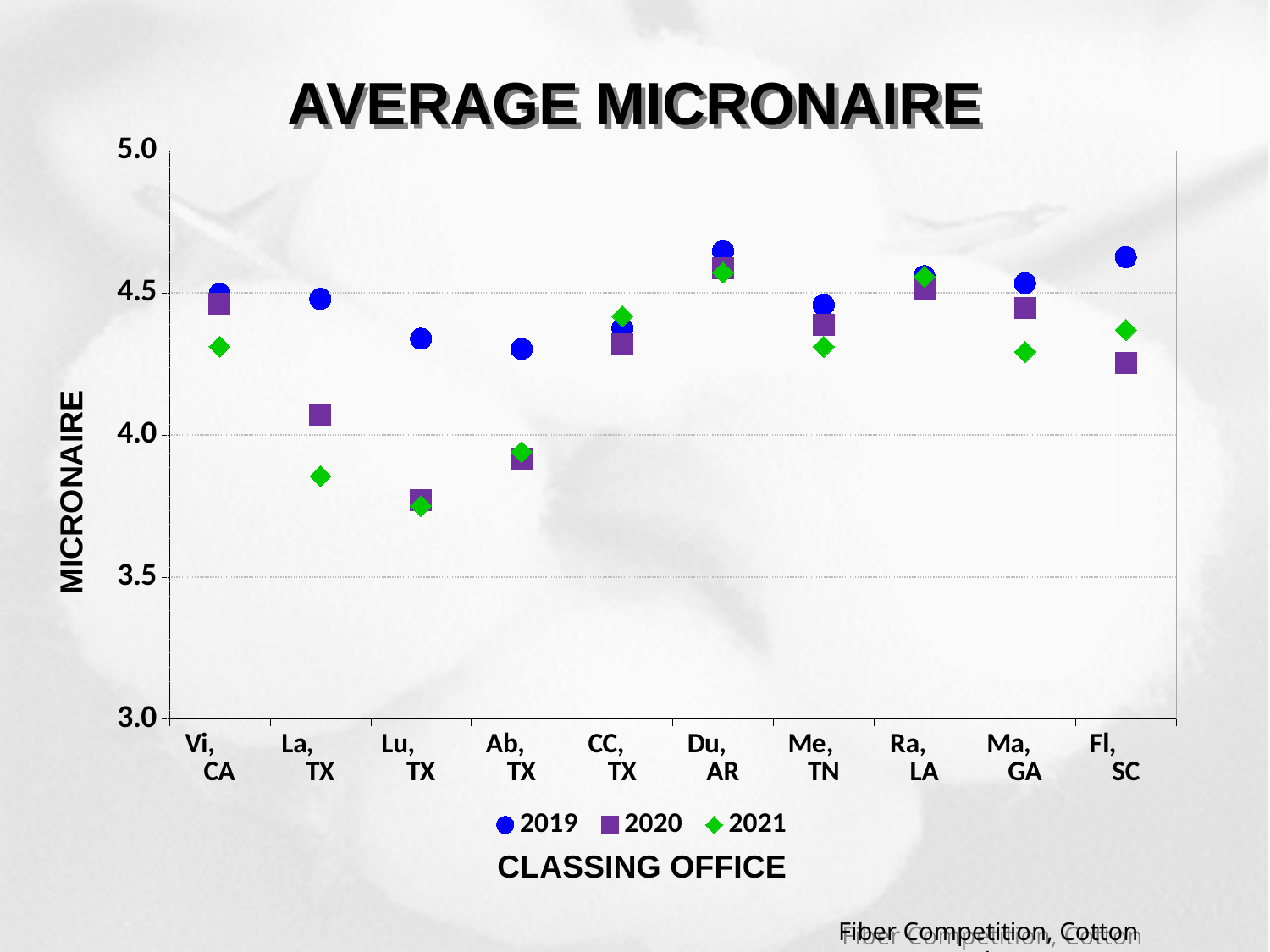
Which classing office has the lowest 2021 value? Lu, TX Which classing office has the highest 2020 value? Du, AR How many series does the legend list? 3 For La, TX, which is larger: the 2019 value or the 2021 value? 2019 Is the 2021 value for La, TX greater or less than 4.0? less For Fl, SC, which is larger: the 2020 value or the 2021 value? 2021 What is the title of the vertical axis? MICRONAIRE What type of chart is shown on the slide? Scatter chart How many classing offices are shown on the x axis? 10 Is the 2020 value for Fl, SC greater or less than 4.5? less Is the 2019 value for Du, AR greater or less than 4.5? greater Which classing office has the lowest 2020 value? Lu, TX